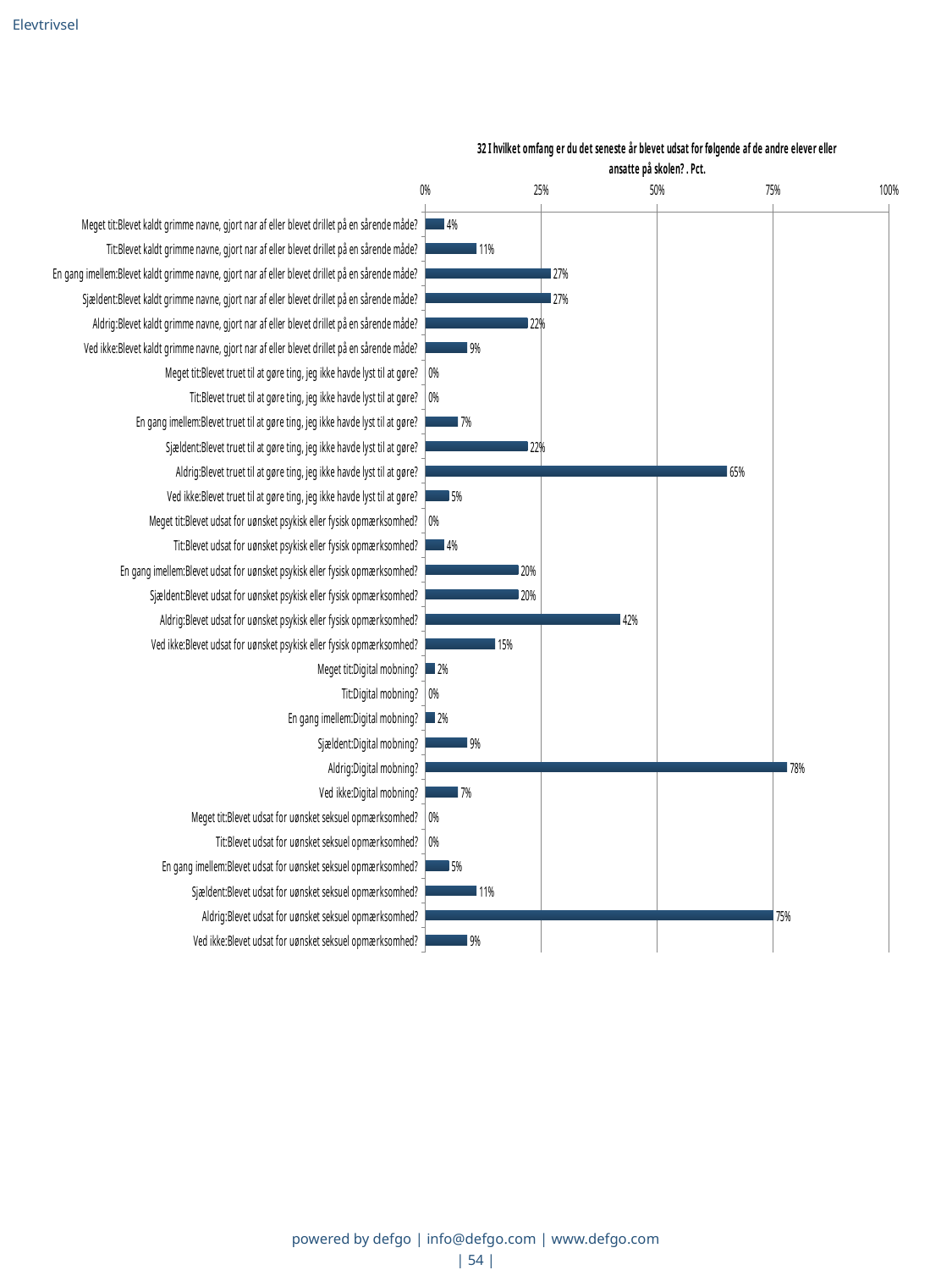
What is the value for "Aldrig:Blevet udsat for uønsket psykisk eller fysisk opmærksomhed?"? 42% Which is larger: the value for "Aldrig:Blevet truet til at gøre ting, jeg ikke havde lyst til at gøre?" or the value for "Aldrig:Blevet udsat for uønsket psykisk eller fysisk opmærksomhed?"? Aldrig:Blevet truet til at gøre ting, jeg ikke havde lyst til at gøre? What is the value for "Aldrig:Blevet truet til at gøre ting, jeg ikke havde lyst til at gøre?"? 65% What is the value for "Aldrig:Digital mobning?"? 78% How many categories are plotted in the chart? 30 What kind of chart is shown on the slide? bar chart What is the difference between the values for "Aldrig:Digital mobning?" and "Aldrig:Blevet udsat for uønsket seksuel opmærksomhed?"? 3 percentage points What is the value for "Ved ikke:Blevet udsat for uønsket seksuel opmærksomhed?"? 9% Is the value for "Aldrig:Blevet truet til at gøre ting, jeg ikke havde lyst til at gøre?" greater or less than 50%? greater What is the value for "En gang imellem:Blevet kaldt grimme navne, gjort nar af eller blevet drillet på en sårende måde?"? 27% Which category has the highest value in the chart? Aldrig:Digital mobning? What is the highest value shown on the horizontal axis of the chart? 100%